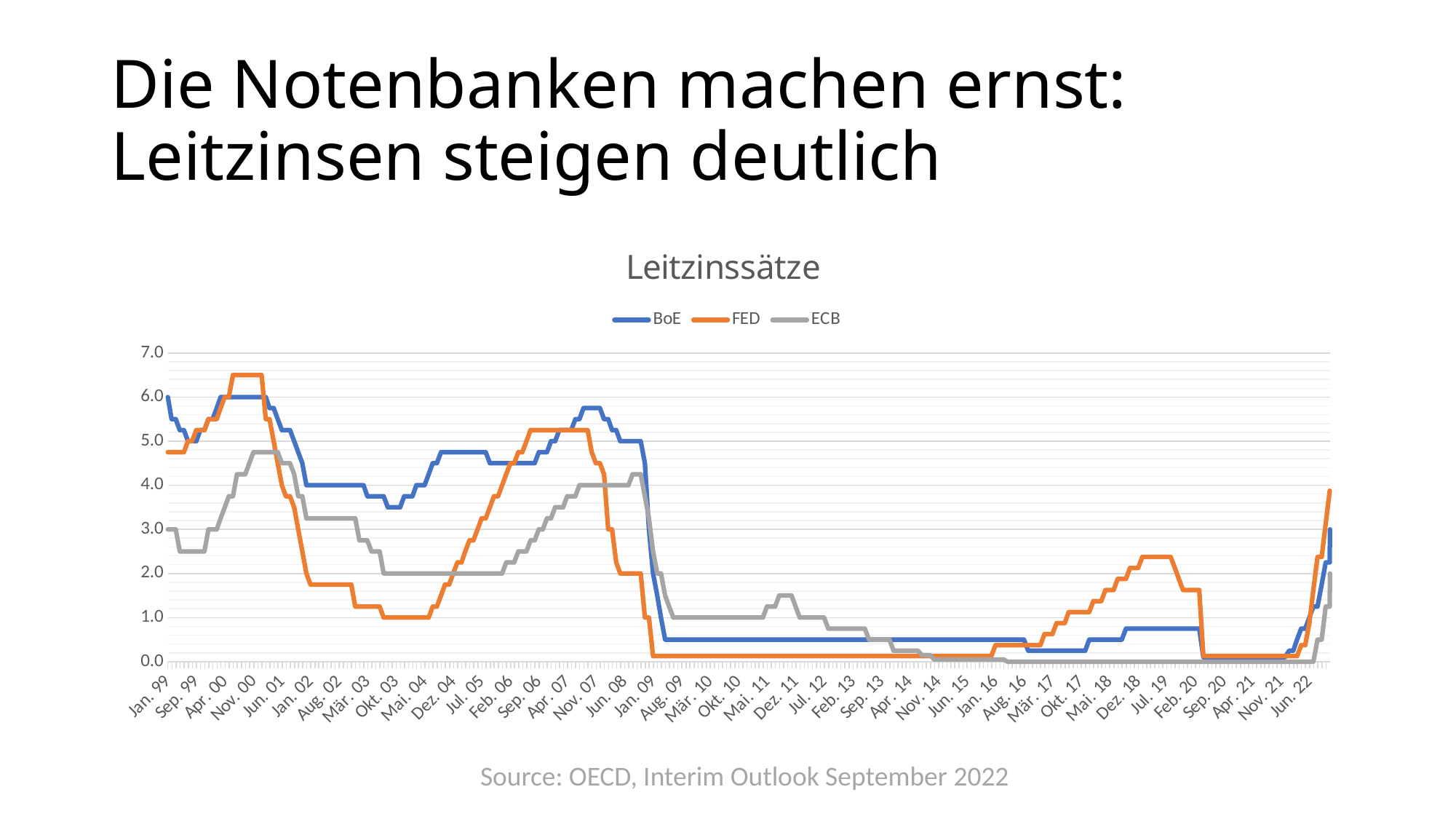
What is the title of the chart? Leitzinssätze Do the BoE values rise or fall between Nov. 07 and Jan. 09? fall Which series reaches the highest value anywhere on the chart? FED Is the FED value around Nov. 00 greater or less than 6.0? greater Is the ECB value around Nov. 00 greater or less than 4.0? greater Which series are listed in the chart legend? BoE, FED, ECB Is the FED value around Jan. 09 greater or less than 1.0? less Around Jul. 19, which series is higher, FED or BoE? FED How many series does the legend of the chart list? 3 Around Nov. 07, which series is higher, BoE or ECB? BoE What kind of chart is shown on the slide? line chart